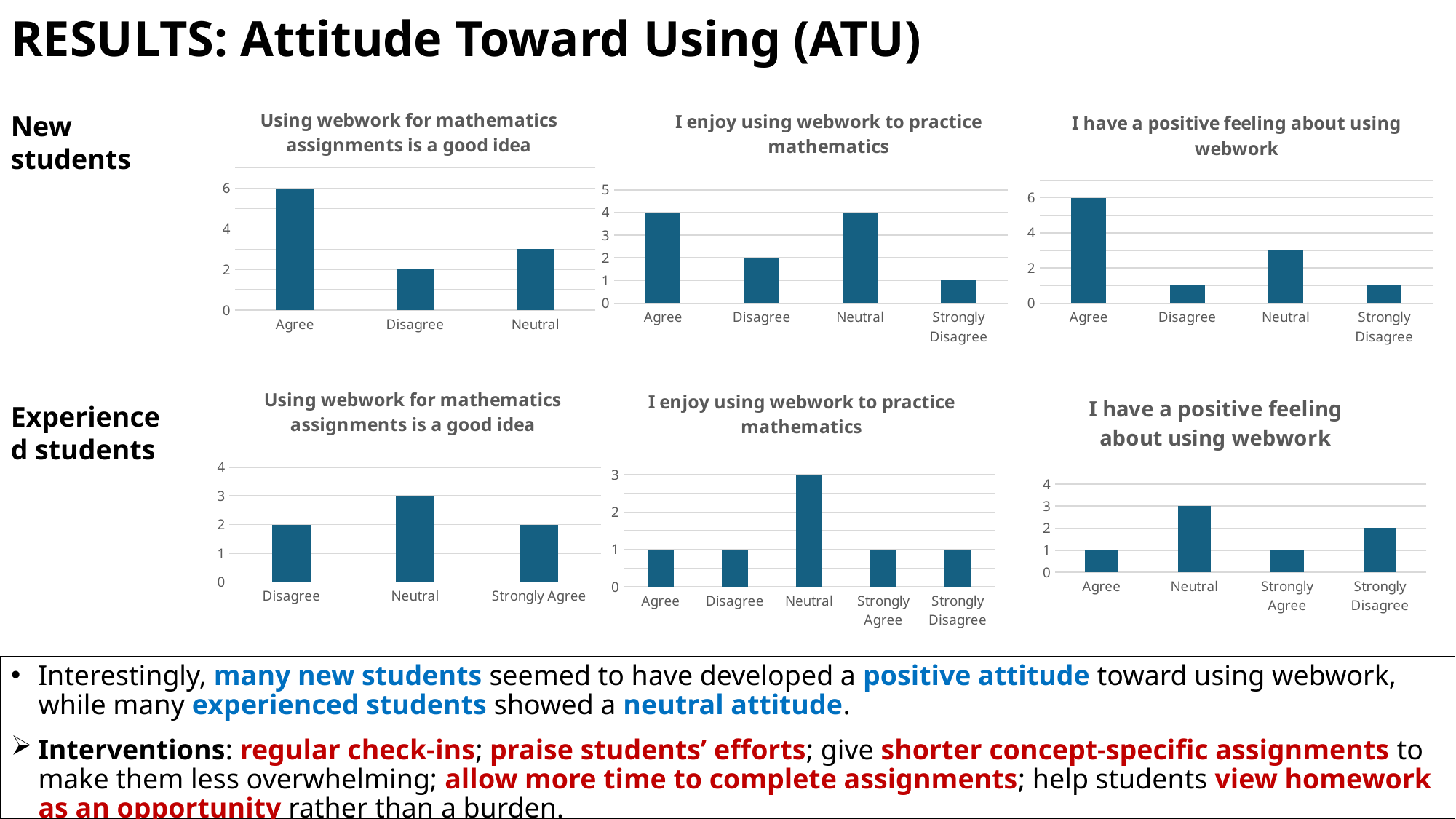
In the New students chart titled "I enjoy using webwork to practice mathematics", how many categories are shown on the x axis? 4 In the Experienced students chart titled "I have a positive feeling about using webwork", which is larger, the value for Neutral or the value for Strongly Disagree? Neutral What type of chart is the Experienced students chart titled "I have a positive feeling about using webwork"? Bar chart In the New students chart titled "I enjoy using webwork to practice mathematics", what is the value for Strongly Disagree? 1 In the New students chart titled "I enjoy using webwork to practice mathematics", what is the difference between the values for Agree and Disagree? 2 In the New students chart titled "I have a positive feeling about using webwork", which category has the highest value? Agree In the Experienced students chart titled "I enjoy using webwork to practice mathematics", which category has the highest value? Neutral In the Experienced students chart titled "Using webwork for mathematics assignments is a good idea", what is the value for Neutral? 3 In the Experienced students chart titled "I enjoy using webwork to practice mathematics", how many categories are shown on the x axis? 5 In the New students chart titled "Using webwork for mathematics assignments is a good idea", what is the value for Agree? 6 In the New students chart titled "I have a positive feeling about using webwork", is the value for Neutral greater or less than 4? less In the New students chart titled "Using webwork for mathematics assignments is a good idea", is the value for Neutral greater or less than 2? greater